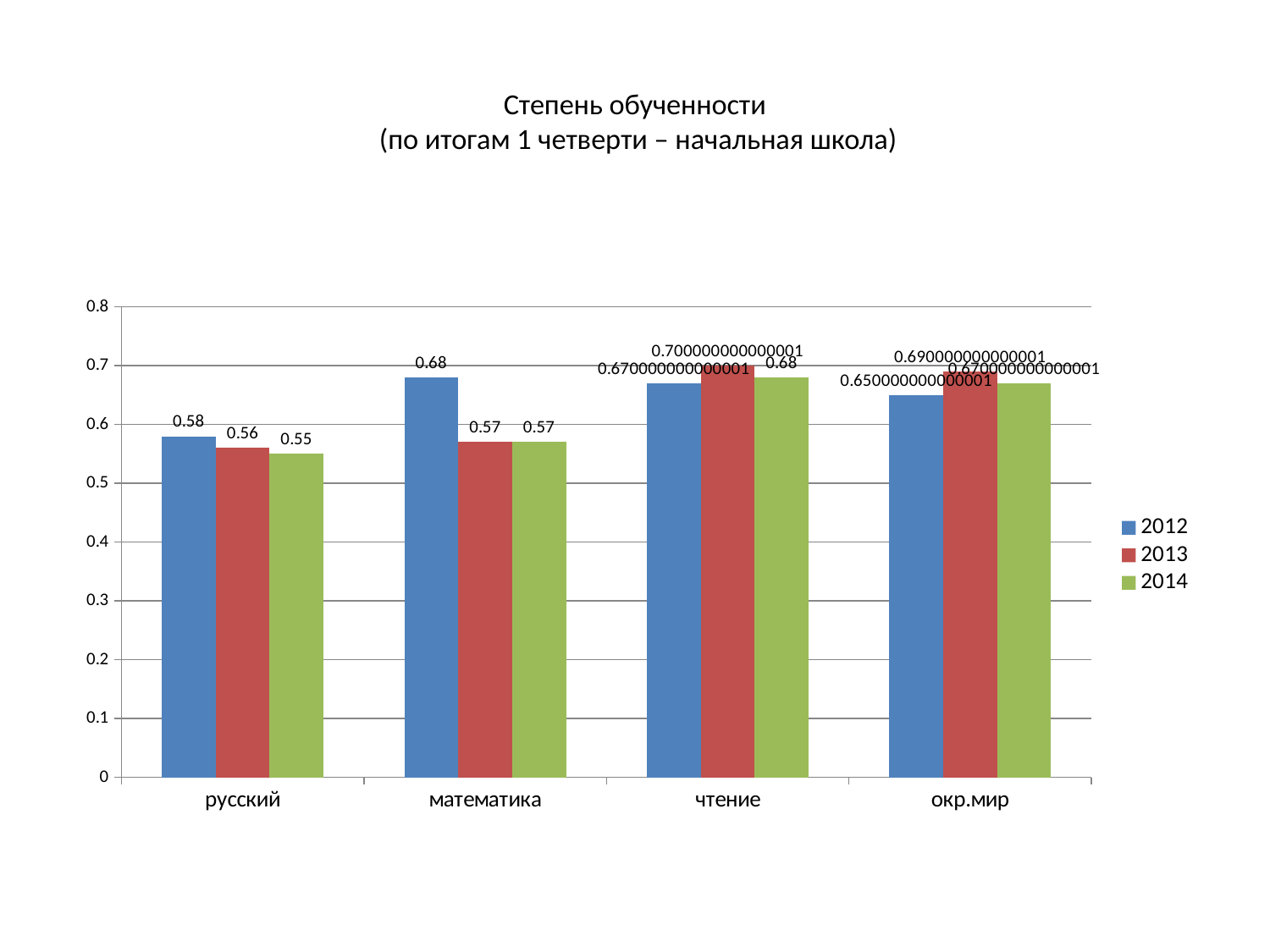
What is the value for русский in the 2014 series? 0.55 Which is larger for русский: the 2012 value or the 2013 value? 2012 Which category has the lowest value in the 2014 series? русский How many series does the legend list? 3 Is the 2013 value for окр.мир greater or less than 0.6? greater What is the value for русский in the 2012 series? 0.58 Which category has the highest value in the 2012 series? математика What kind of chart is shown on the slide? bar chart What is the value for математика in the 2013 series? 0.57 How many categories are shown on the x axis? 4 What is the value for чтение in the 2014 series? 0.68 What is the difference between the 2012 and 2013 values for математика? 0.11